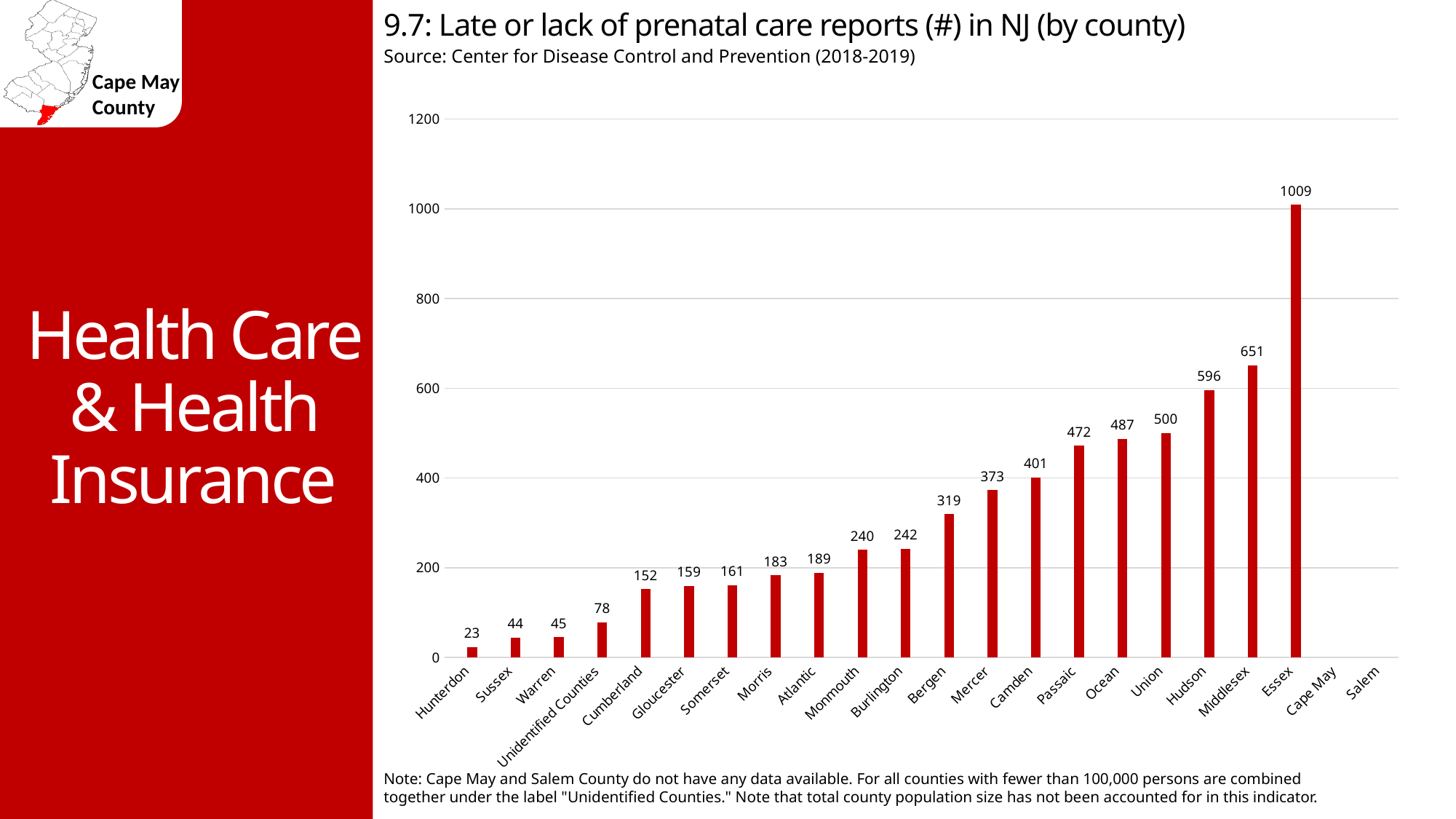
Which two counties on the x axis have no bar because no data is available? Cape May and Salem What is the number of late or lack of prenatal care reports for Cumberland? 152 Do the bar values generally rise or fall from left to right across the counties with data? Rise Which county with a plotted bar has the lowest number of reports? Hunterdon What is the difference between the values for Essex and Middlesex? 358 How many county labels are shown on the x axis? 22 Is the value for Bergen greater or less than 400? less What is the number of late or lack of prenatal care reports for Essex? 1009 What kind of chart is shown on the slide? Bar chart What is the value shown for Unidentified Counties? 78 Which county has the highest number of late or lack of prenatal care reports? Essex Which has more reports, Hudson or Union? Hudson